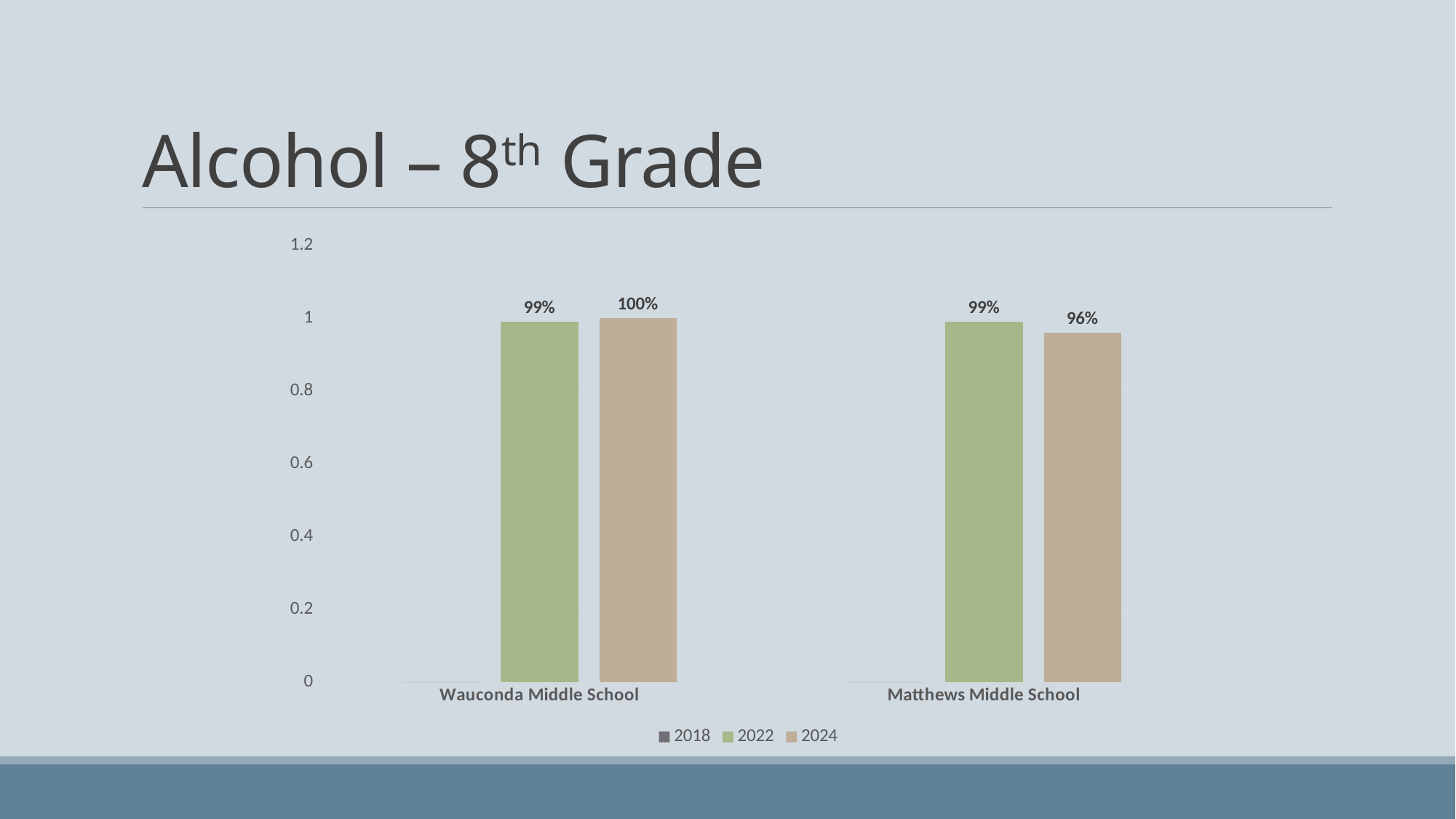
What is the difference between the 2022 and 2024 values for Matthews Middle School? 3% How many series does the legend list? 3 What is the title of the slide? Alcohol – 8th Grade What is the 2024 value for Matthews Middle School? 96% What kind of chart is shown on the slide? Bar chart How many schools are shown on the x axis? 2 What is the difference between the 2024 values for Wauconda Middle School and Matthews Middle School? 4% Which is larger for Wauconda Middle School, the 2022 value or the 2024 value? 2024 Which school has the lower 2024 value? Matthews Middle School What is the 2022 value for Matthews Middle School? 99% What is the 2022 value for Wauconda Middle School? 99% What is the 2024 value for Wauconda Middle School? 100%